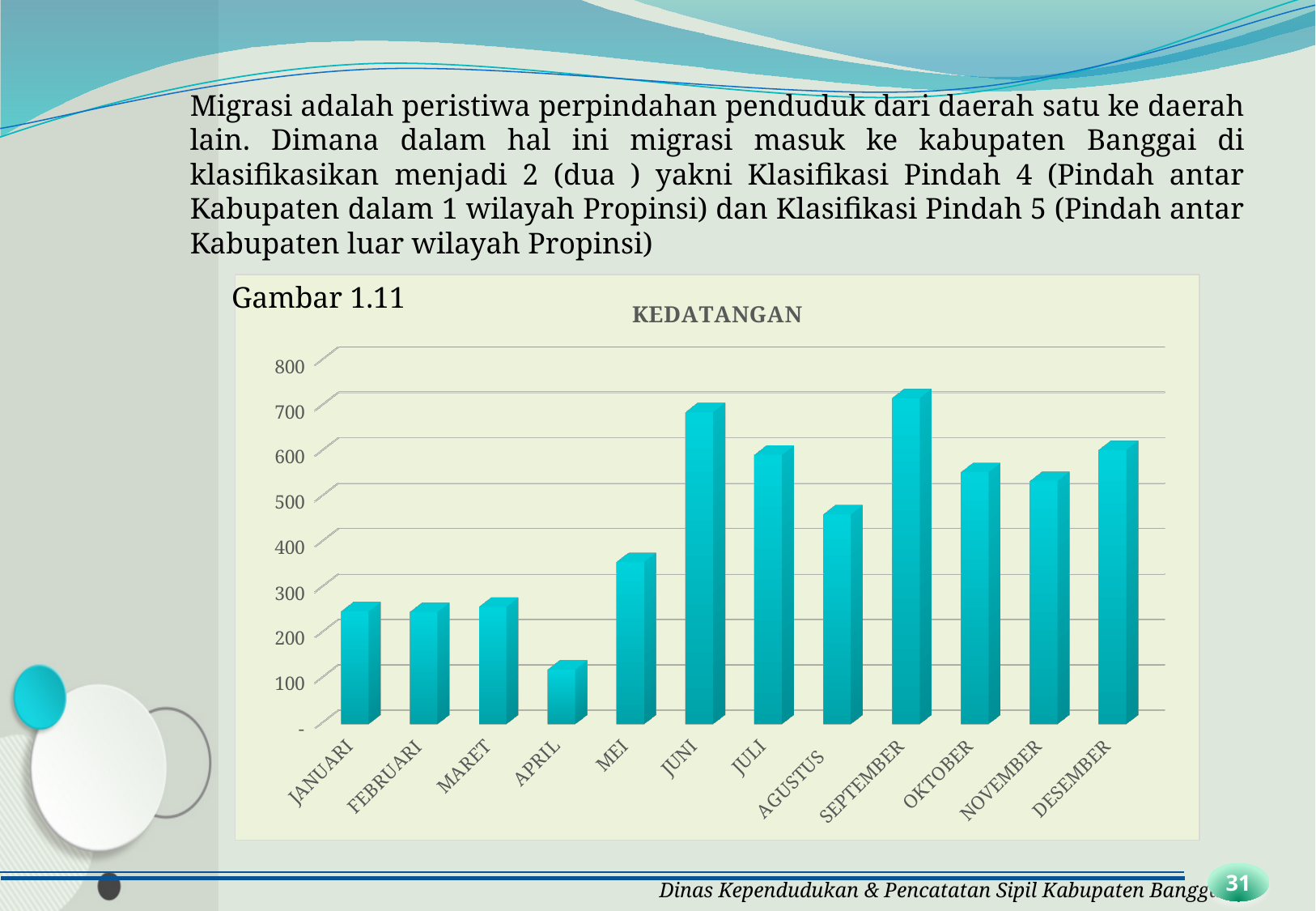
Is the value for APRIL greater or less than 200? less How many months (categories) are shown on the x axis of the chart? 12 Which month has the lowest value in the chart? APRIL Is the value for JUNI greater or less than 600? greater Do the values rise or fall from APRIL to JUNI? rise Is the value for AGUSTUS greater or less than 500? less Which is larger, the value for AGUSTUS or the value for OKTOBER? OKTOBER What is the title of the chart? KEDATANGAN What kind of chart is shown on the slide? bar chart Which month has the highest value in the chart? SEPTEMBER Which is larger, the value for JUNI or the value for JULI? JUNI